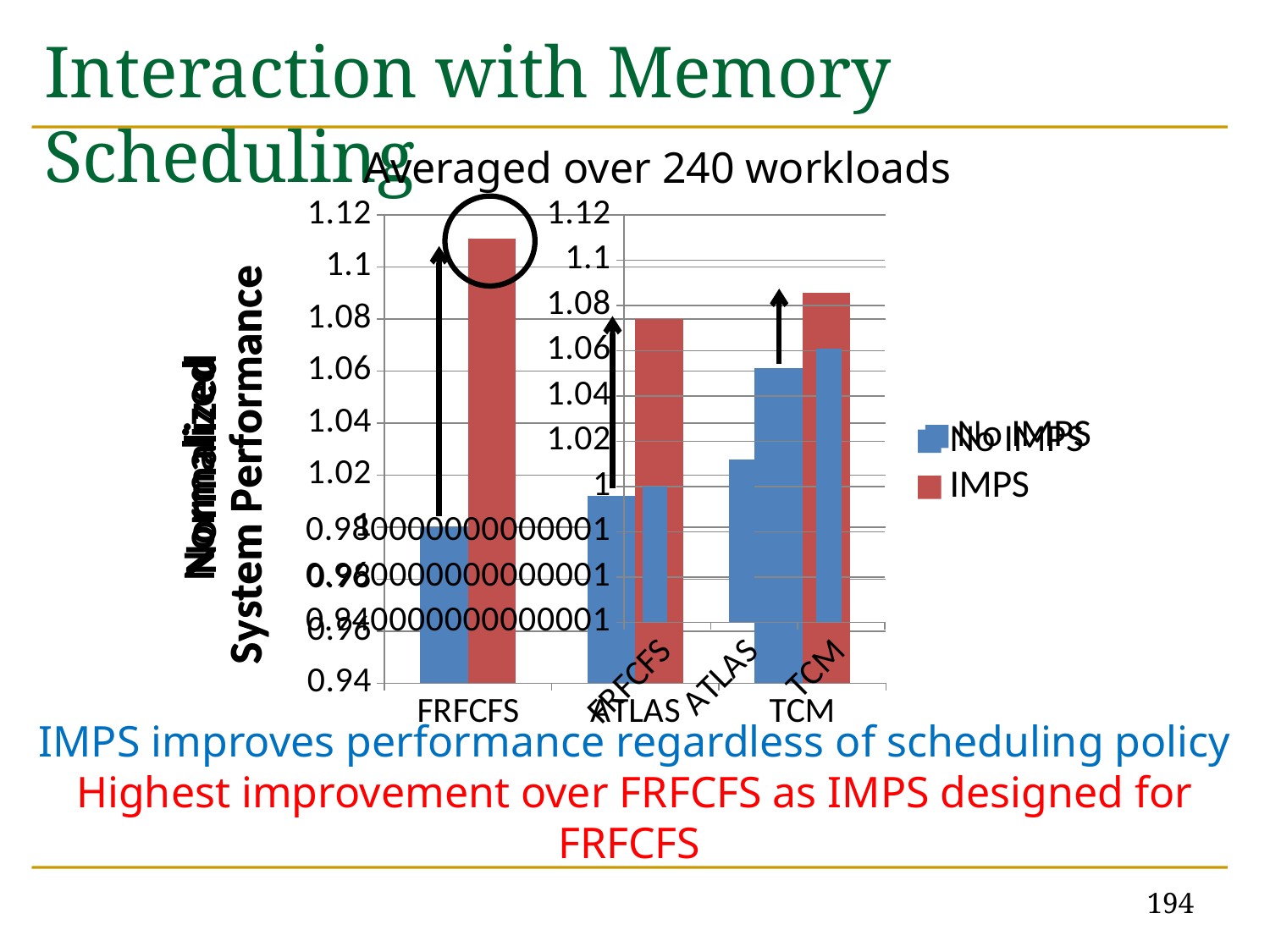
What kind of chart is shown on the slide? bar chart Is the IMPS value for FRFCFS greater or less than 1.08? greater For FRFCFS, which is larger: the IMPS value or the No IMPS value? IMPS Is the No IMPS value for FRFCFS greater or less than 1.04? less Which scheduling policy has the highest IMPS value? FRFCFS For TCM, which is larger: the IMPS value or the No IMPS value? IMPS How many series does the chart legend list? 2 How many scheduling policy categories are shown on the x axis of the chart? 3 What are the two series named in the chart legend? No IMPS and IMPS What is the title of the chart? Averaged over 240 workloads